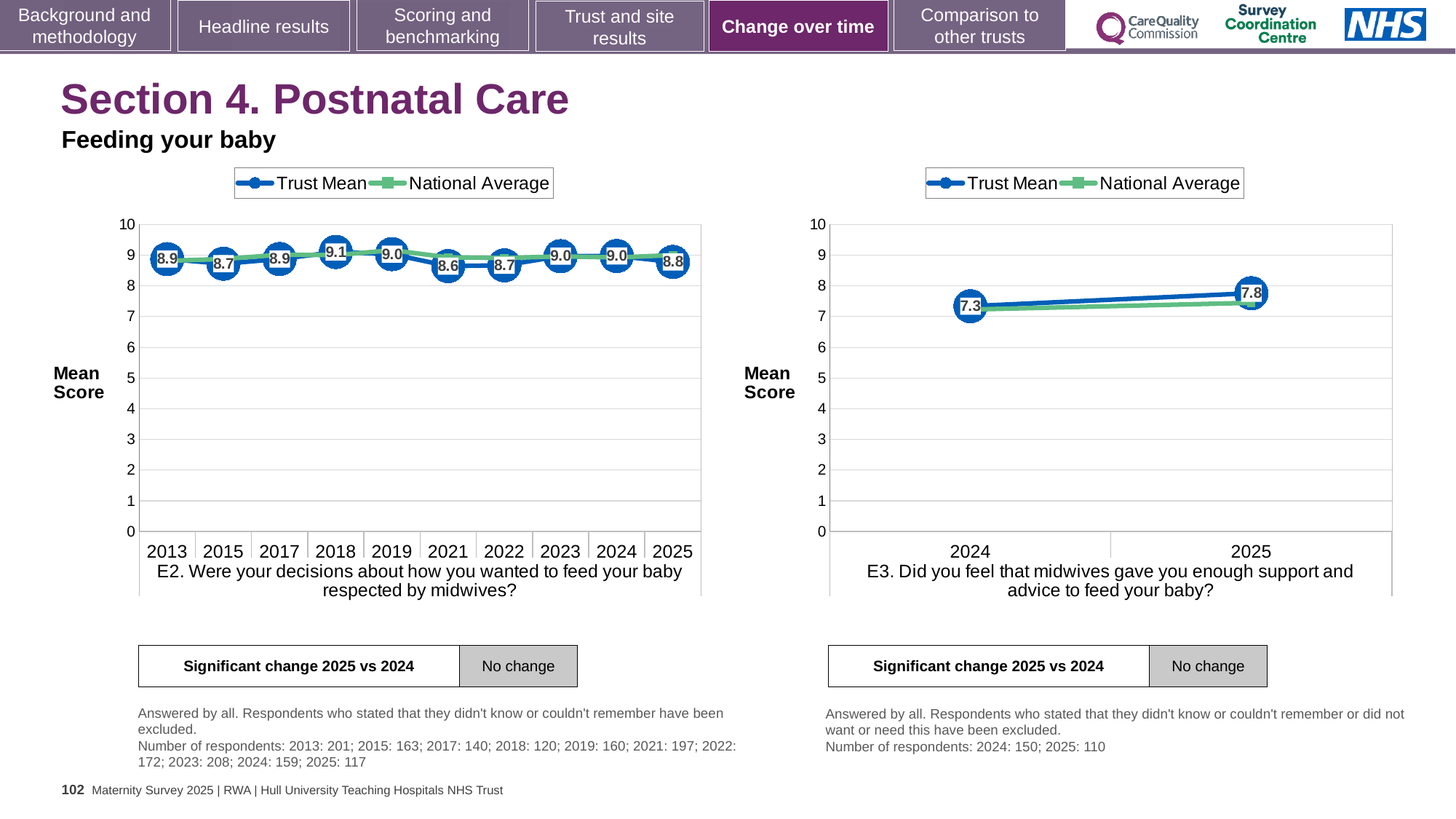
In the E2 chart on the left, what is the Trust Mean score for 2021? 8.6 In the E3 chart on the right, what is the Trust Mean score for 2025? 7.8 In the E2 chart on the left, which year has the highest Trust Mean score? 2018 In the E3 chart on the right, what is the difference between the Trust Mean scores for 2025 and 2024? 0.5 How many series does the legend of the E3 chart on the right list? 2 In the E2 chart on the left, what is the Trust Mean score for 2018? 9.1 In the E2 chart on the left, which year has the lowest Trust Mean score? 2021 In the E3 chart on the right, is the National Average value for 2025 greater or less than 8? less How many years are plotted on the x axis of the E2 chart on the left? 10 What type of chart is the E3 chart on the right? Line chart In the E3 chart on the right, does the Trust Mean rise or fall from 2024 to 2025? Rise In the E2 chart on the left, is the Trust Mean score higher in 2013 or in 2015? 2013